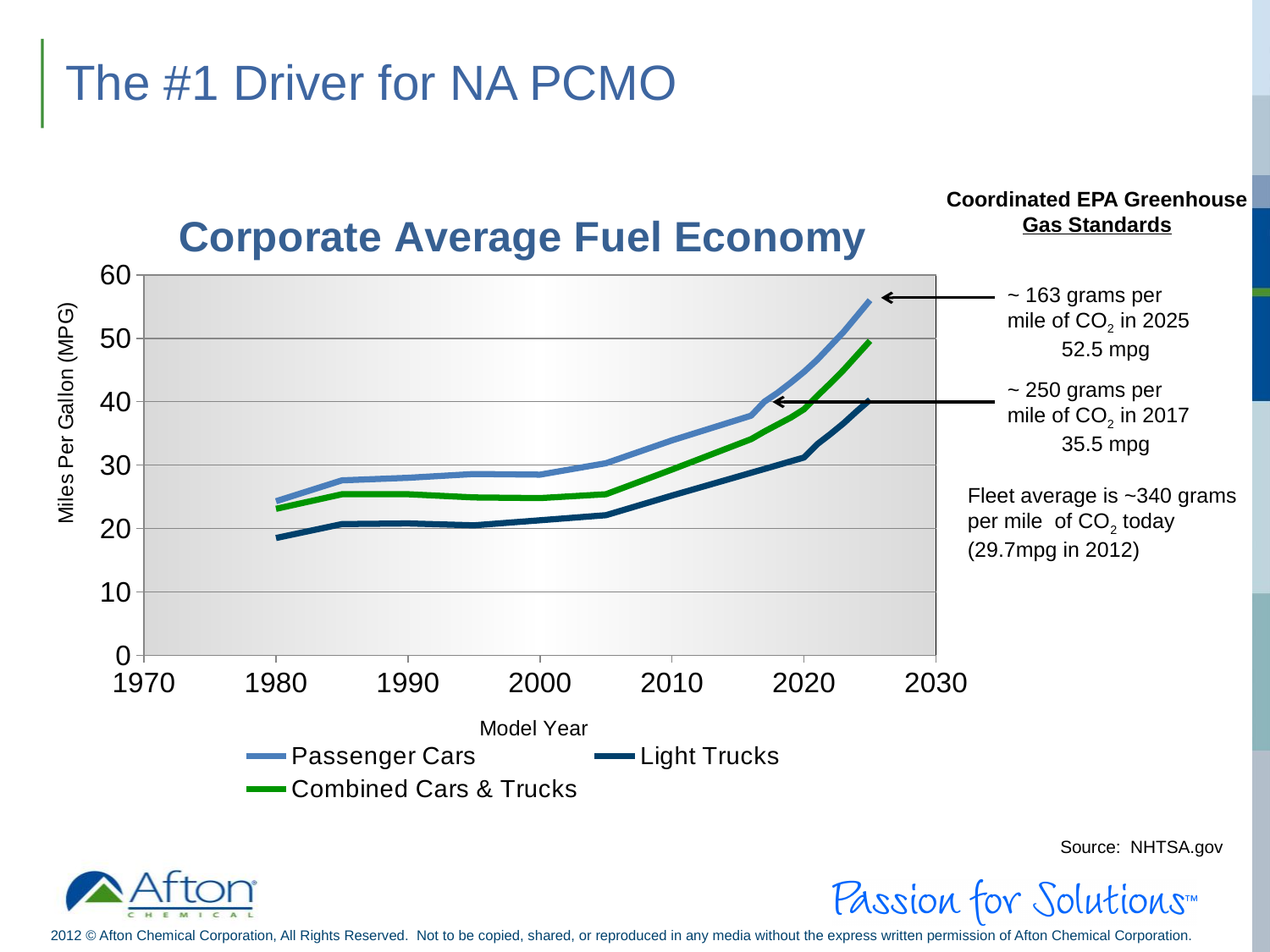
Is the value for Light Trucks in 1980 greater or less than 20? less What is the title of the chart on the slide? Corporate Average Fuel Economy Is the value for Passenger Cars in 2025 greater or less than 50? greater Is the value for Combined Cars & Trucks in 2000 greater or less than 30? less How many series does the legend of the Corporate Average Fuel Economy chart list? 3 What kind of chart is shown on the slide? line chart Does the Passenger Cars line rise or fall from 1980 to 2025? rise What is the label of the vertical axis of the chart? Miles Per Gallon (MPG) Which series has the highest value in 2020? Passenger Cars Which series has the lowest value in 1990? Light Trucks In 2000, which is higher: Passenger Cars or Light Trucks? Passenger Cars